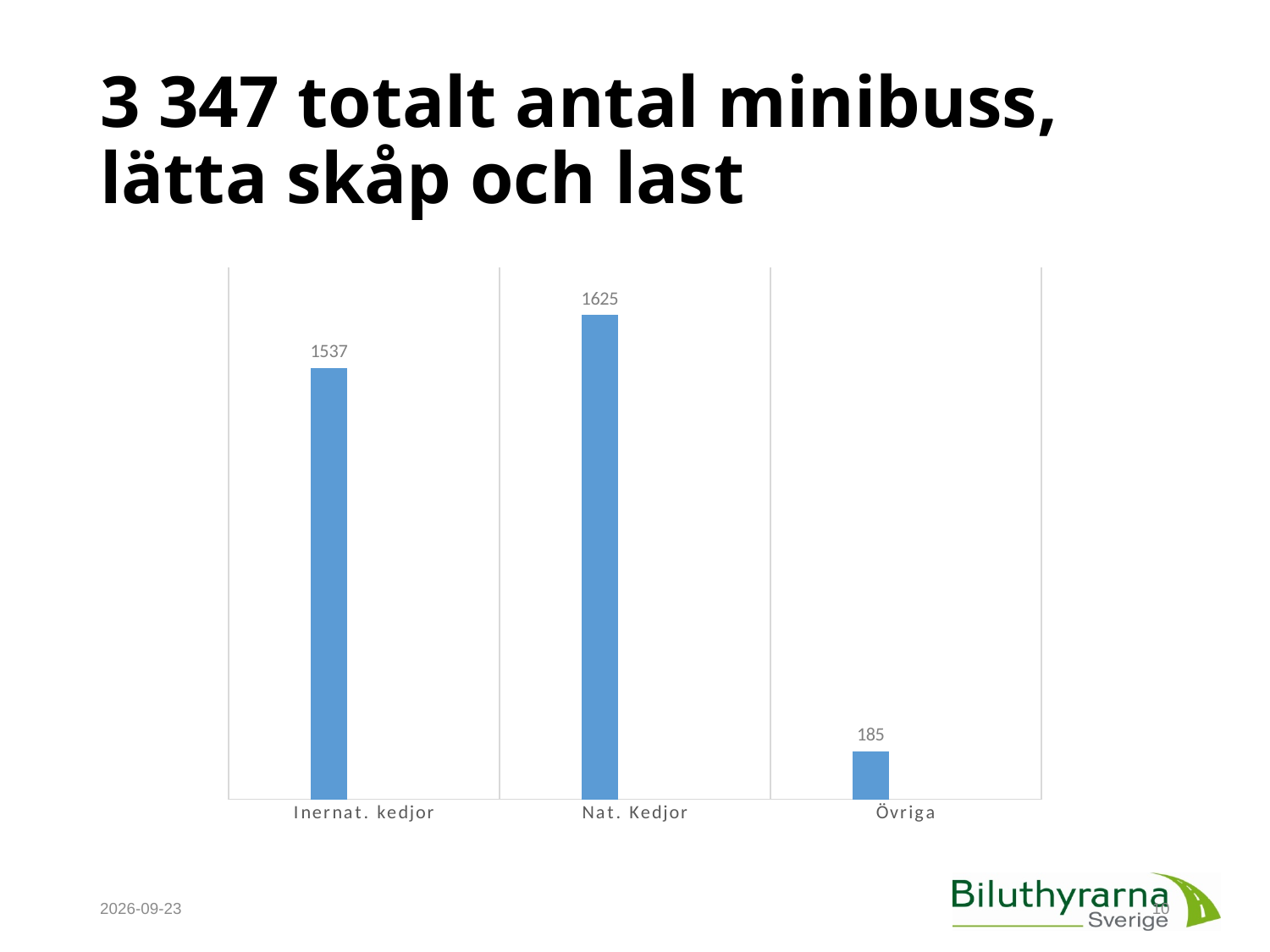
What is the difference between the values for Nat. Kedjor and Inernat. kedjor? 88 What kind of chart is shown on the slide? bar chart What is the difference between the values for Inernat. kedjor and Övriga? 1352 What is the total of the three values shown in the chart? 3347 Which category has the lowest value? Övriga What is the value for Nat. Kedjor? 1625 Which category has the highest value? Nat. Kedjor What is the value for Inernat. kedjor? 1537 What is the title of the slide? 3 347 totalt antal minibuss, lätta skåp och last Which is larger, the value for Inernat. kedjor or the value for Övriga? Inernat. kedjor What is the value for Övriga? 185 How many categories are shown in the chart? 3